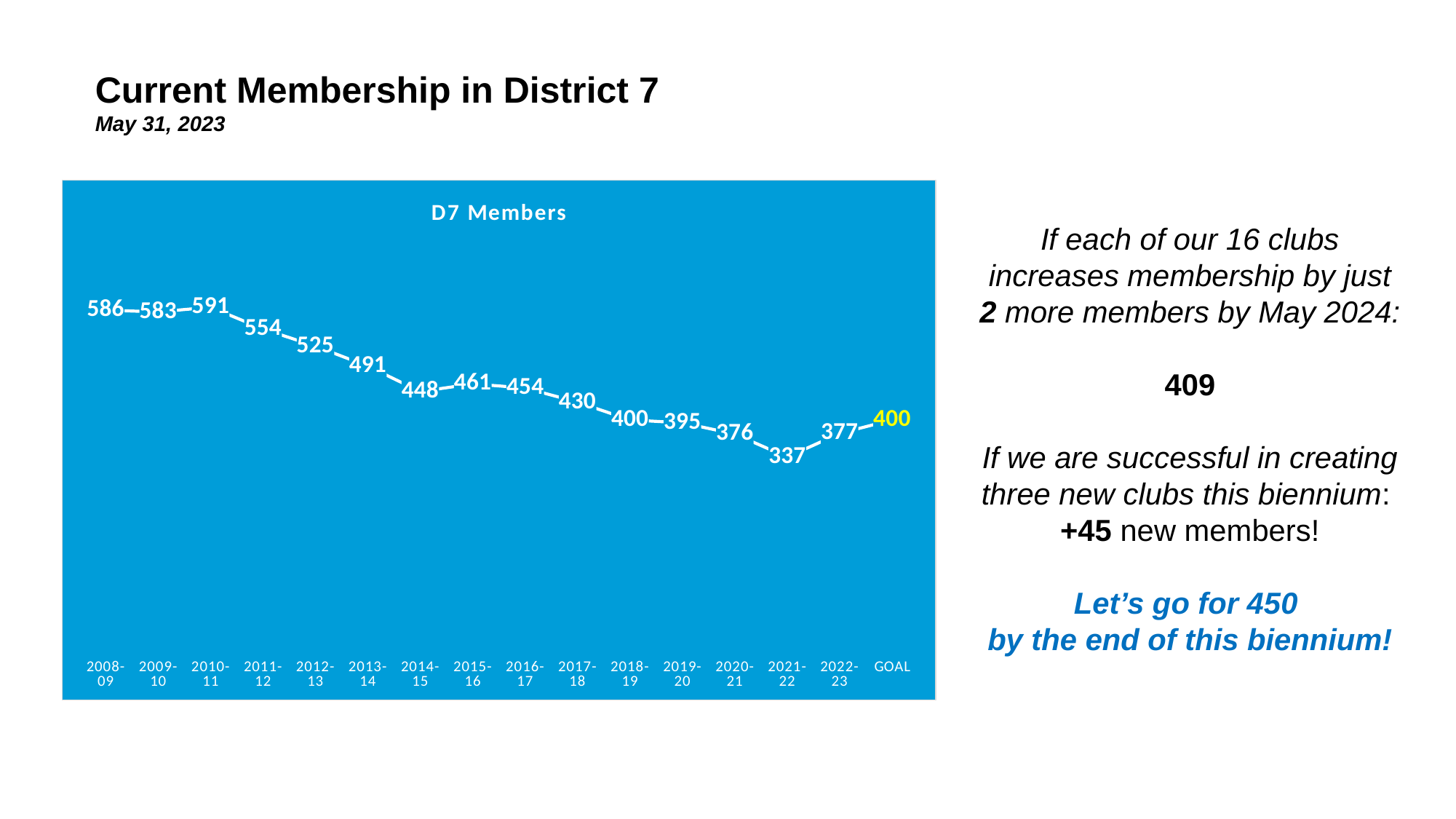
What is the value for 2022-23 in the D7 Members chart? 377 Which is larger in the D7 Members chart, the value for 2015-16 or the value for 2016-17? 2015-16 What kind of chart is the D7 Members chart? line chart What is the value for 2008-09 in the D7 Members chart? 586 What is the title of the chart on the slide? D7 Members What is the value for 2021-22 in the D7 Members chart? 337 What is the difference between the values for 2008-09 and 2022-23 in the D7 Members chart? 209 Do the values in the D7 Members chart generally rise or fall from 2008-09 to 2021-22? fall Which category has the lowest value in the D7 Members chart? 2021-22 Which category has the highest value in the D7 Members chart? 2010-11 What is the value shown for GOAL in the D7 Members chart? 400 How many categories are shown on the x axis of the D7 Members chart? 16